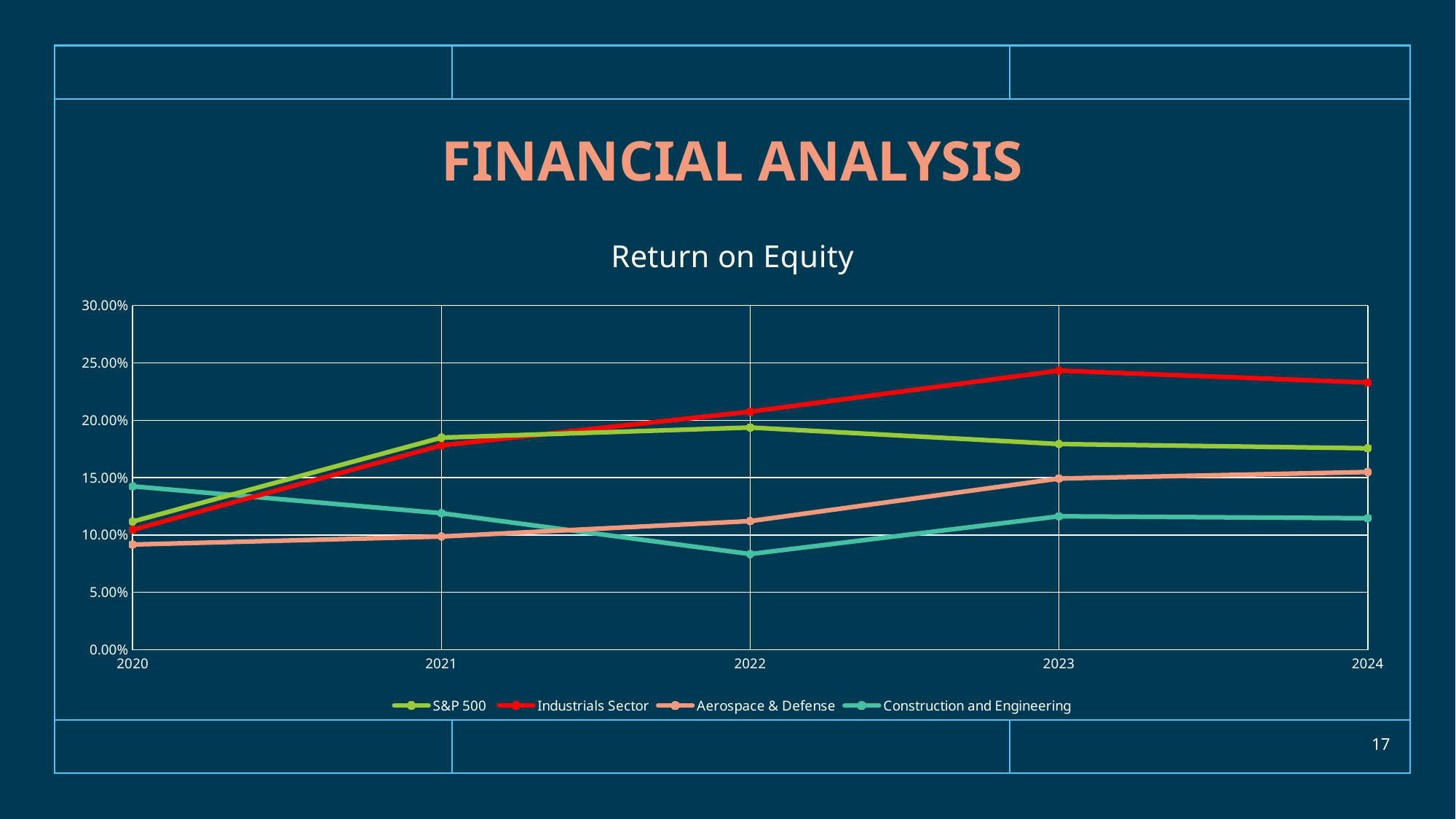
Does the Aerospace & Defense line rise or fall from 2020 to 2024? rise In 2020, which has the higher return on equity: Construction and Engineering or S&P 500? Construction and Engineering Is the value for S&P 500 in 2022 greater or less than 15.00%? greater In which year is the Industrials Sector return on equity highest? 2023 In which year is the Construction and Engineering return on equity lowest? 2022 Is the value for Industrials Sector in 2023 greater or less than 20.00%? greater What kind of chart is shown on the slide? line chart How many years are plotted along the x axis? 5 In 2024, which has the higher return on equity: Industrials Sector or S&P 500? Industrials Sector How many series does the legend list? 4 Is the value for Aerospace & Defense in 2020 greater or less than 10.00%? less What is the title of the chart? Return on Equity